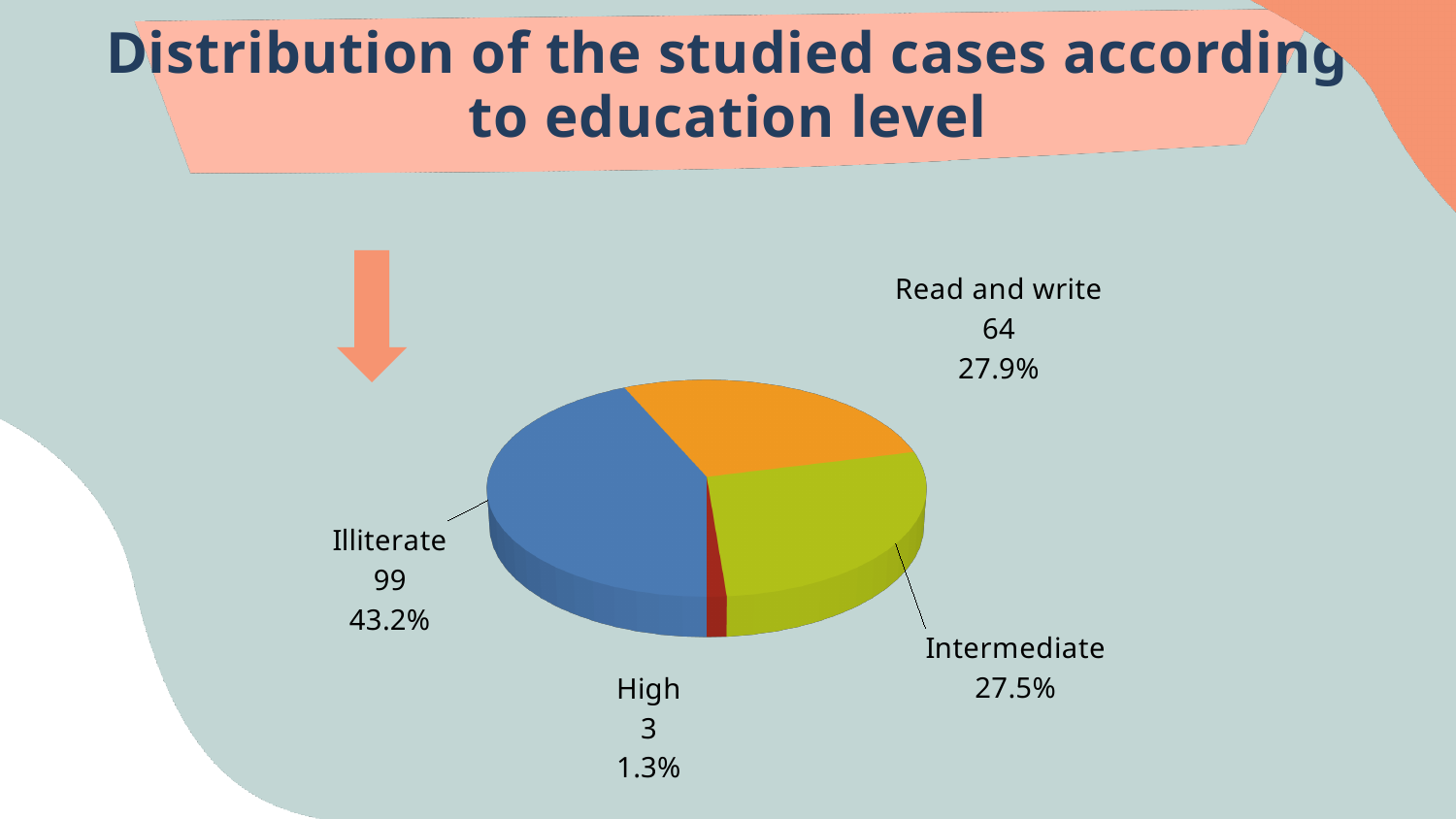
How many education level categories does the pie chart show? 4 Which education level category has the largest share of the studied cases? Illiterate How many studied cases have a High education level? 3 What share of the pie does the Illiterate category represent? 43.2% Which education level category has the smallest share of the studied cases? High What is the title of the chart? Distribution of the studied cases according to education level What share of the pie does the Intermediate category represent? 27.5% How many studied cases are Illiterate? 99 Which category has more cases, Read and write or High? Read and write How many more cases are Illiterate than Read and write? 35 How many studied cases are in the Read and write category? 64 What kind of chart is shown on the slide? pie chart